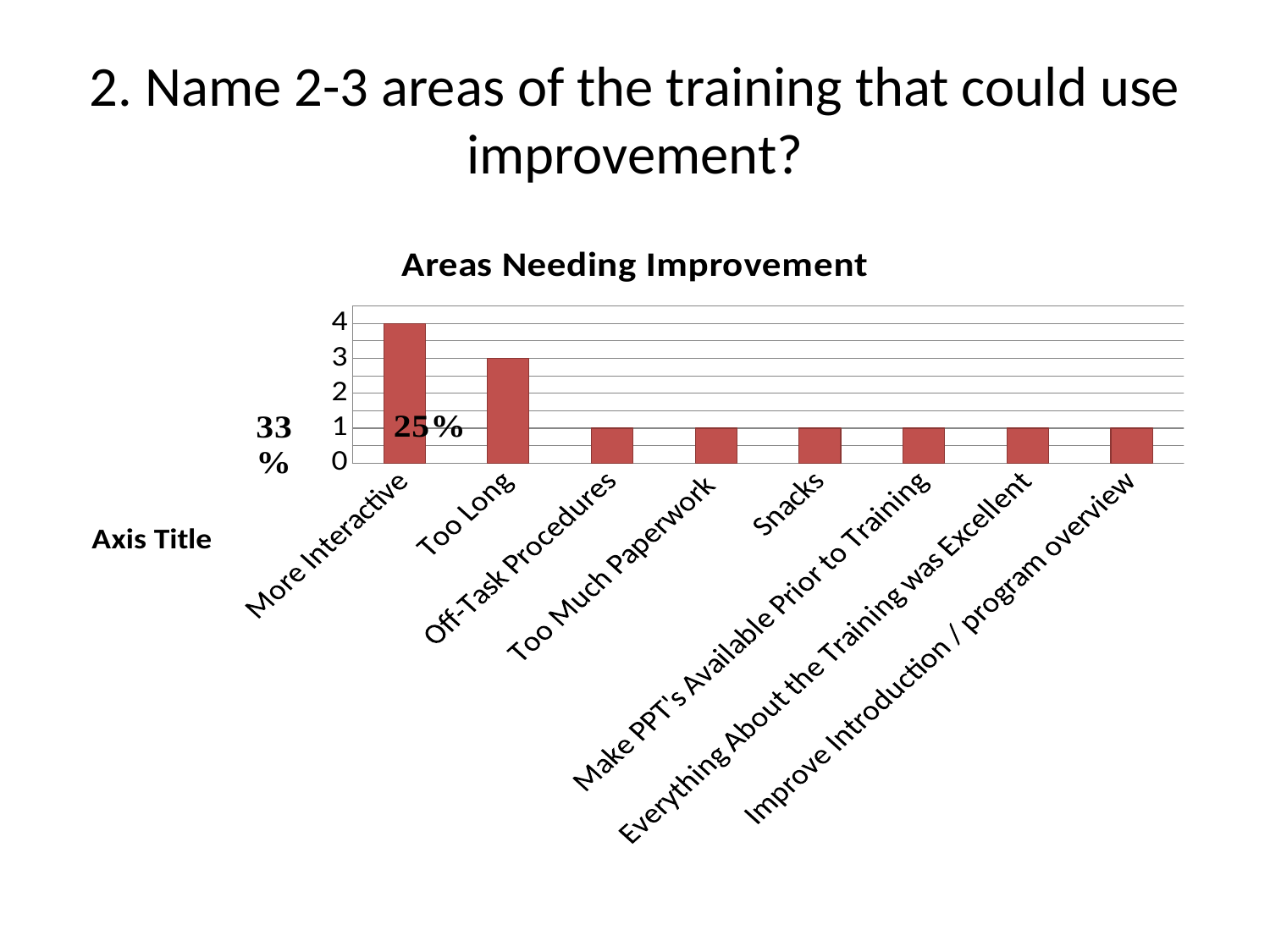
What type of chart is shown under the title "Areas Needing Improvement"? bar chart What is the difference between the values for "Too Long" and "Improve Introduction / program overview"? 2 Which is larger, the value for "Too Long" or the value for "Off-Task Procedures"? Too Long What is the value for "Too Much Paperwork"? 1 Is the value for "More Interactive" greater or less than 2? greater What is the value for "Snacks"? 1 Which category has the highest value? More Interactive What is the value for "Too Long"? 3 What is the difference between the values for "More Interactive" and "Too Long"? 1 What is the title of the chart? Areas Needing Improvement How many categories are plotted in the chart? 8 What is the value for "More Interactive"? 4